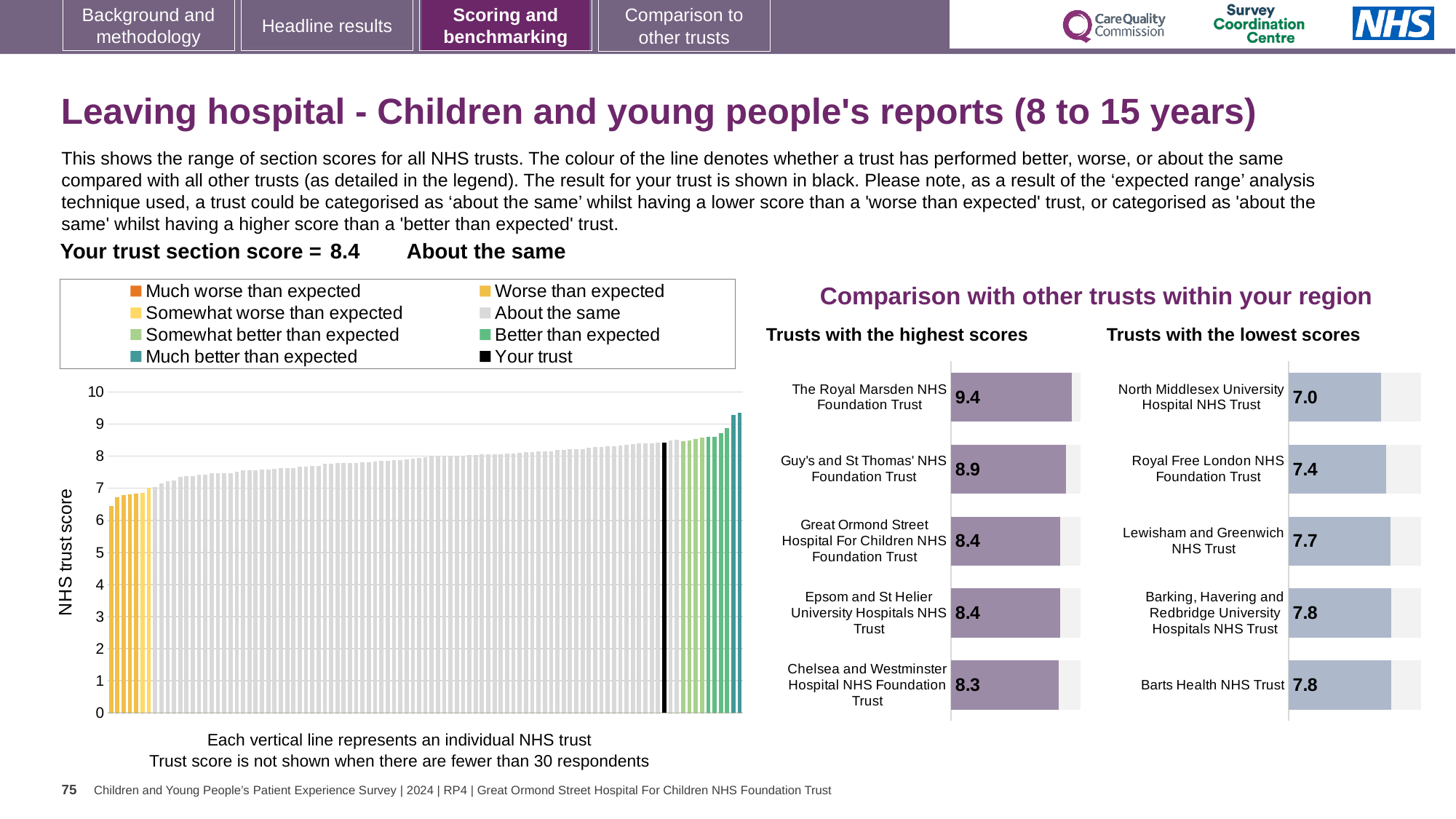
How many trusts are shown in the 'Trusts with the highest scores' chart? 5 What kind of chart is the large chart on the left showing the range of section scores for all NHS trusts? Bar chart In the 'Trusts with the highest scores' chart, which trust has the highest score? The Royal Marsden NHS Foundation Trust In the 'Trusts with the lowest scores' chart, which trust has the lowest score? North Middlesex University Hospital NHS Trust In the 'Trusts with the lowest scores' chart, what is the difference between the scores of Barts Health NHS Trust and North Middlesex University Hospital NHS Trust? 0.8 In the 'Trusts with the highest scores' chart, what is the difference between the scores of The Royal Marsden NHS Foundation Trust and Chelsea and Westminster Hospital NHS Foundation Trust? 1.1 What is the label on the vertical axis of the left-hand chart? NHS trust score In the 'Trusts with the highest scores' chart, what is the score for The Royal Marsden NHS Foundation Trust? 9.4 How many entries does the legend of the left-hand chart list? 8 In the left-hand chart of all NHS trusts, do the scores rise or fall from left to right? Rise In the 'Trusts with the lowest scores' chart, what is the score for North Middlesex University Hospital NHS Trust? 7.0 In the 'Trusts with the lowest scores' chart, which has the larger score: Royal Free London NHS Foundation Trust or Lewisham and Greenwich NHS Trust? Lewisham and Greenwich NHS Trust